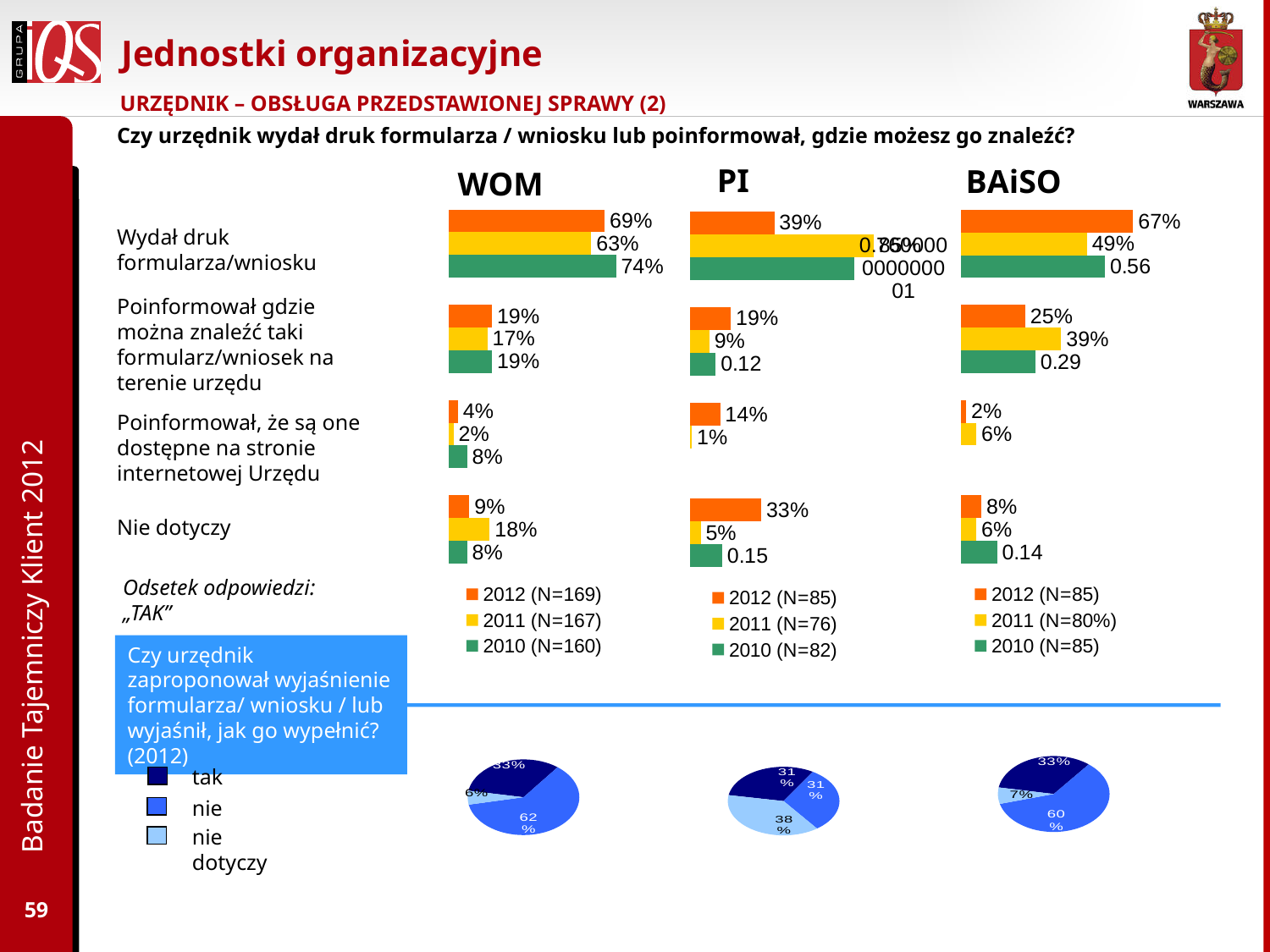
In the WOM bar chart, what is the 2011 value for "Nie dotyczy"? 18% In the WOM bar chart, which year has the highest value for "Wydał druk formularza/wniosku"? 2010 In the BAiSO bar chart, what is the difference between the 2012 and 2011 values for "Wydał druk formularza/wniosku"? 18% In the WOM bar chart, what is the 2012 value for "Wydał druk formularza/wniosku"? 69% In the PI bar chart, which is larger for "Poinformował, że są one dostępne na stronie internetowej Urzędu": the 2012 value or the 2011 value? 2012 In the PI bar chart, what is the 2011 value for "Poinformował gdzie można znaleźć taki formularz/wniosek na terenie urzędu"? 9% In the WOM bar chart, what is the difference between the 2010 and 2011 values for "Wydał druk formularza/wniosku"? 11% In the PI bar chart, what is the 2012 value for "Nie dotyczy"? 33% In the BAiSO bar chart, what is the 2012 value for "Wydał druk formularza/wniosku"? 67% How many series does the legend of the WOM bar chart list? 3 What sample size (N) does the WOM chart legend give for 2012? N=169 In the BAiSO bar chart, what is the 2011 value for "Poinformował gdzie można znaleźć taki formularz/wniosek na terenie urzędu"? 39%